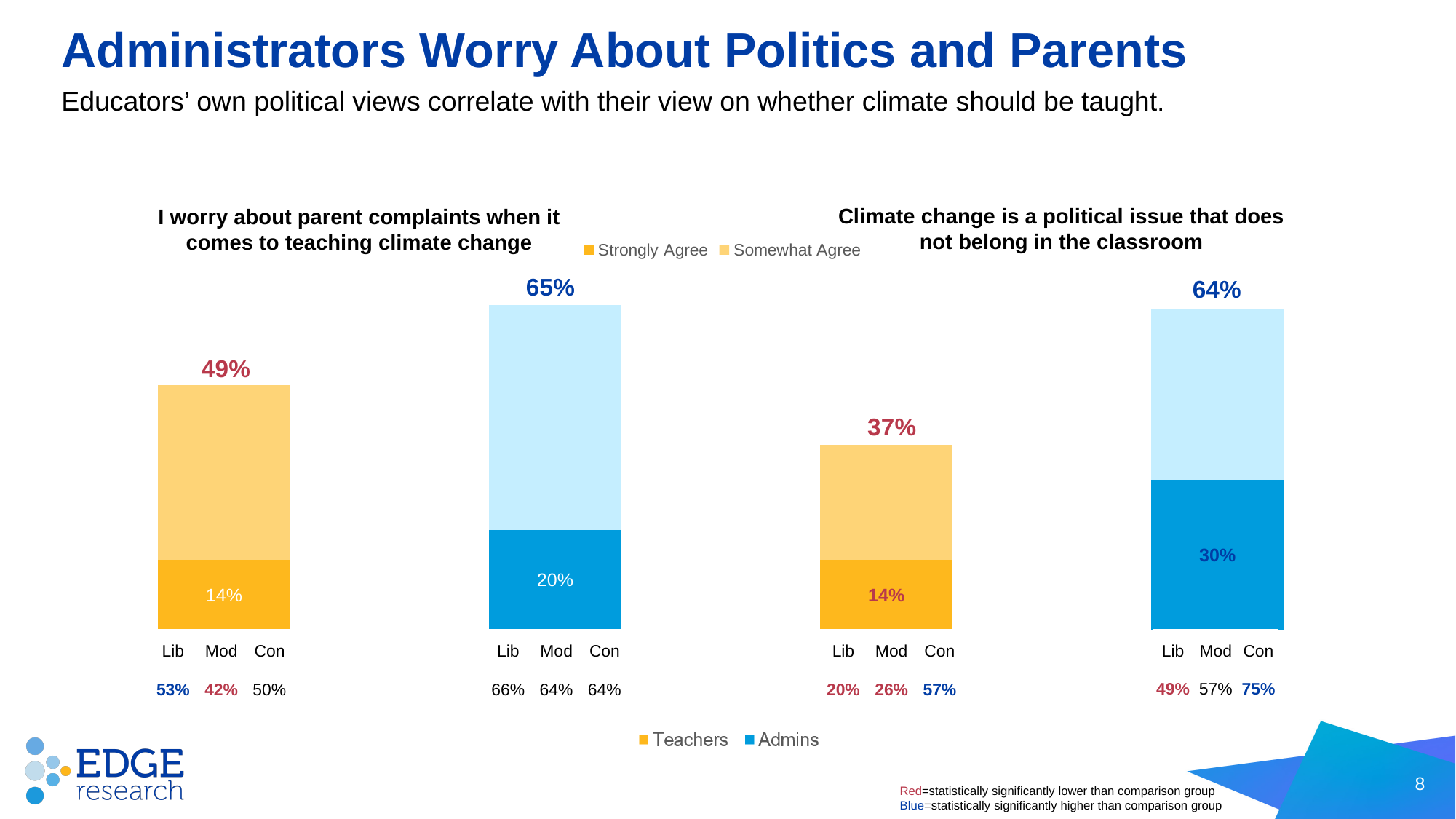
How many series does the Strongly Agree / Somewhat Agree legend list? 2 In the left chart, 'I worry about parent complaints when it comes to teaching climate change', what is the total agreement for Teachers? 49% In the right chart, 'Climate change is a political issue that does not belong in the classroom', what percentage of Admins strongly agree? 30% In the right chart, 'Climate change is a political issue that does not belong in the classroom', what is the total agreement for Teachers? 37% In the left chart, 'I worry about parent complaints when it comes to teaching climate change', what percentage of Teachers strongly agree? 14% What type of chart is used on this slide? Stacked bar chart In the right chart, 'Climate change is a political issue that does not belong in the classroom', which political group of Teachers (Lib, Mod, Con) has the lowest agreement? Lib In the left chart, 'I worry about parent complaints when it comes to teaching climate change', what is the difference in total agreement between Admins and Teachers? 16 percentage points In the right chart, 'Climate change is a political issue that does not belong in the classroom', what is the difference between the Strongly Agree percentages for Admins and Teachers? 16 percentage points In the right chart, 'Climate change is a political issue that does not belong in the classroom', what is the agreement among conservative (Con) Admins? 75% In the right chart, 'Climate change is a political issue that does not belong in the classroom', which group has the higher total agreement, Teachers or Admins? Admins In the left chart, 'I worry about parent complaints when it comes to teaching climate change', what is the total agreement for Admins? 65%